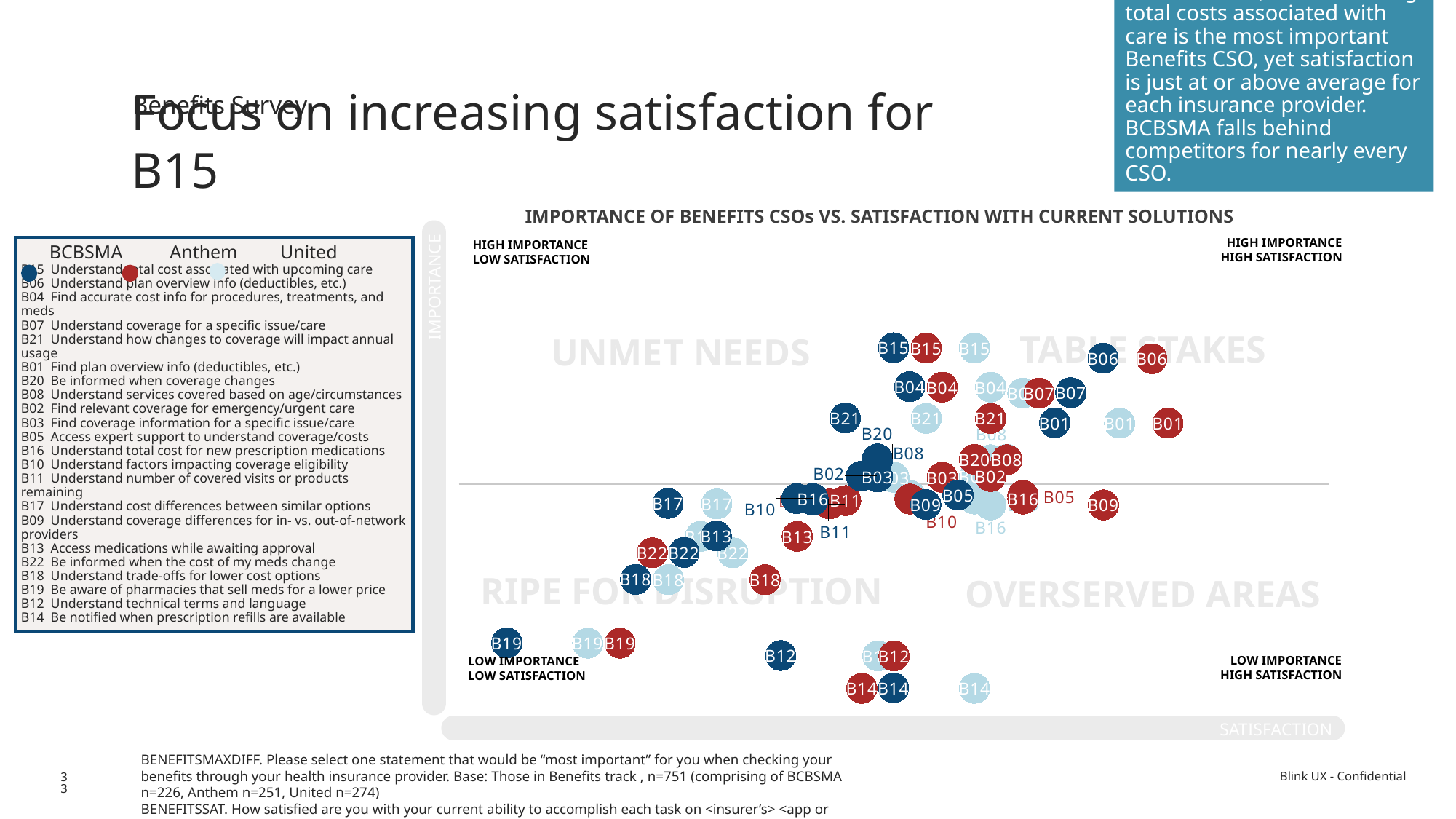
In which quadrant does B19 fall? Ripe for disruption (low importance, low satisfaction) Which CSO is plotted highest on the importance axis? B15 How many CSOs (B-codes) are plotted for each provider? 22 Which has higher importance, B15 or B19? B15 What kind of chart is shown on the slide? Scatter chart Which CSO point is furthest to the left on the satisfaction axis? B19 (BCBSMA) Which has higher satisfaction, B06 or B18? B06 Which CSO is plotted lowest on the importance axis? B14 How many series does the legend list? 3 Which CSO point is furthest to the right on the satisfaction axis? B01 (Anthem) What is the title of the chart? IMPORTANCE OF BENEFITS CSOs VS. SATISFACTION WITH CURRENT SOLUTIONS Which insurance providers are listed in the legend? BCBSMA, Anthem, United